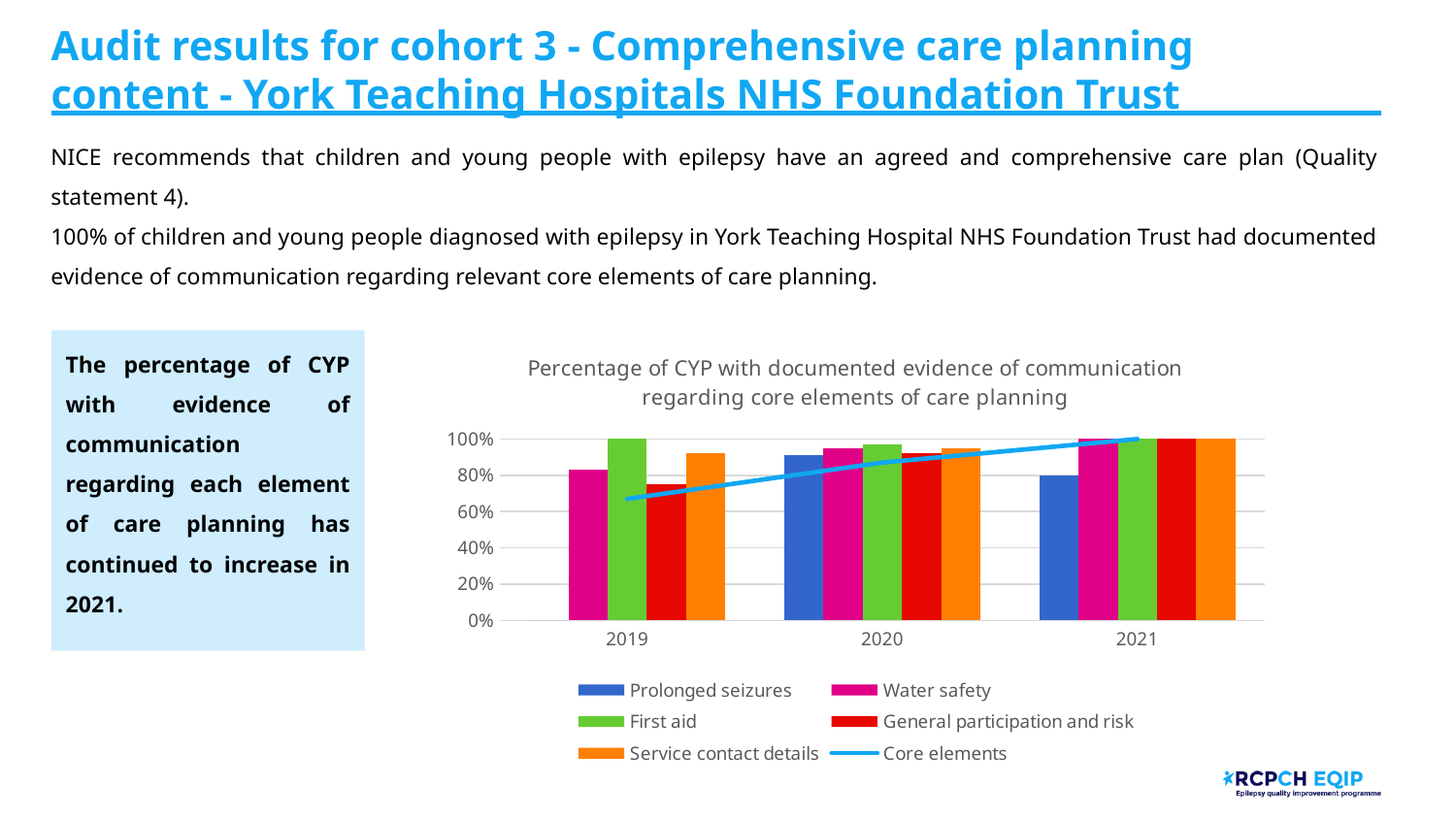
Which series is drawn as a line rather than bars? Core elements What is the value for First aid in 2021? 100% In 2019, which is larger: First aid or General participation and risk? First aid Is the value for General participation and risk in 2019 greater or less than 80%? less How many entries does the chart legend list? 6 Does the Core elements line rise or fall from 2019 to 2021? Rises What is the value for Service contact details in 2021? 100% What kind of chart is shown on the slide? Bar and line chart What is the value for First aid in 2019? 100% How many years are shown on the x axis of the chart? 3 Is the value for Water safety in 2019 greater or less than 100%? less Is the value for Prolonged seizures in 2021 greater or less than 100%? less